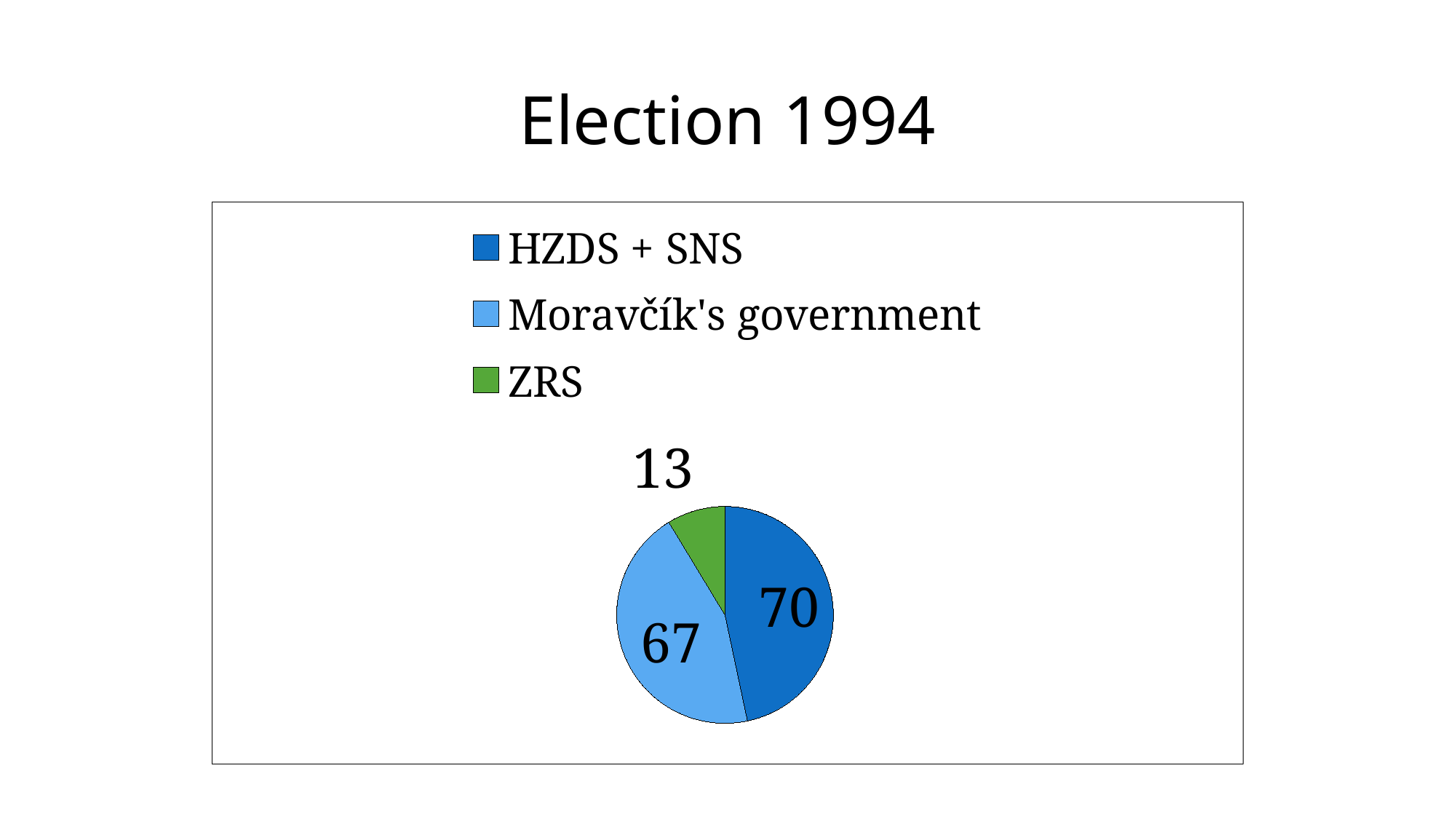
What value is shown for Moravčík's government? 67 What is the total of all the slices in the pie chart? 150 Which is larger, the value for Moravčík's government or the value for ZRS? Moravčík's government What is the difference between the values for HZDS + SNS and Moravčík's government? 3 What is the title of the chart? Election 1994 Which category has the largest slice of the pie? HZDS + SNS Which category has the smallest slice of the pie? ZRS What value is shown for HZDS + SNS? 70 What value is shown for ZRS? 13 What kind of chart is shown on the slide? Pie chart What is the difference between the values for Moravčík's government and ZRS? 54 How many slices does the pie chart have? 3